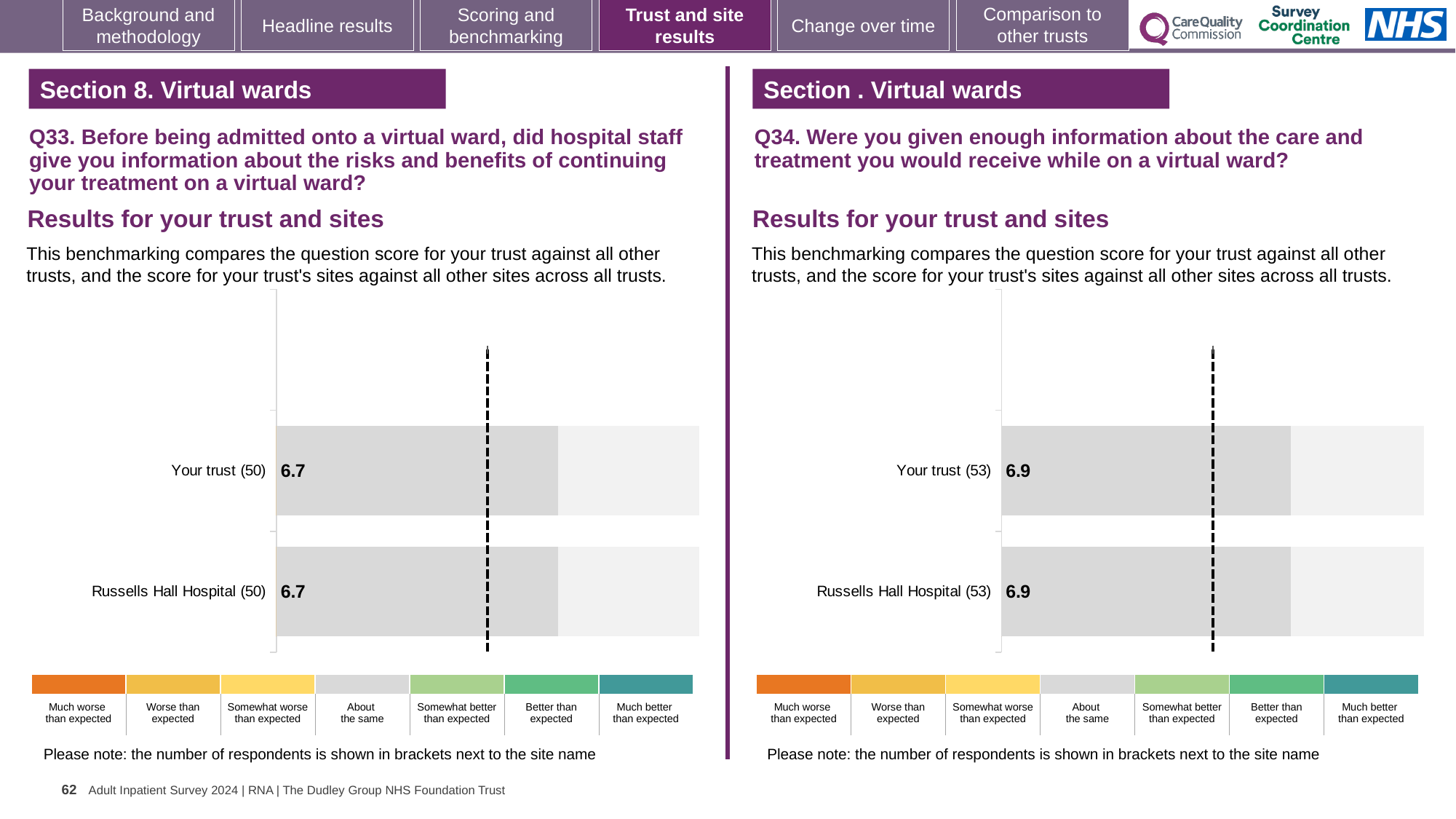
What kind of chart is used on the left (Q33)? Bar chart On the left chart (Q33), how many respondents are shown in brackets for Russells Hall Hospital? 50 On the right chart (Q34), what is the score for Russells Hall Hospital? 6.9 On the right chart (Q34), what is the difference between the score for Your trust and the score for Russells Hall Hospital? 0 How many bars are plotted on the left chart (Q33)? 2 On the left chart (Q33), what is the difference between the score for Your trust and the score for Russells Hall Hospital? 0 On the left chart (Q33), what is the score for Russells Hall Hospital? 6.7 How many bars are plotted on the right chart (Q34)? 2 On the right chart (Q34), what is the score for Your trust? 6.9 On the left chart (Q33), what is the score for Your trust? 6.7 On the right chart (Q34), how many respondents are shown in brackets for Your trust? 53 On the right chart (Q34), which benchmark category does the grey colour of the bars correspond to in the legend? About the same